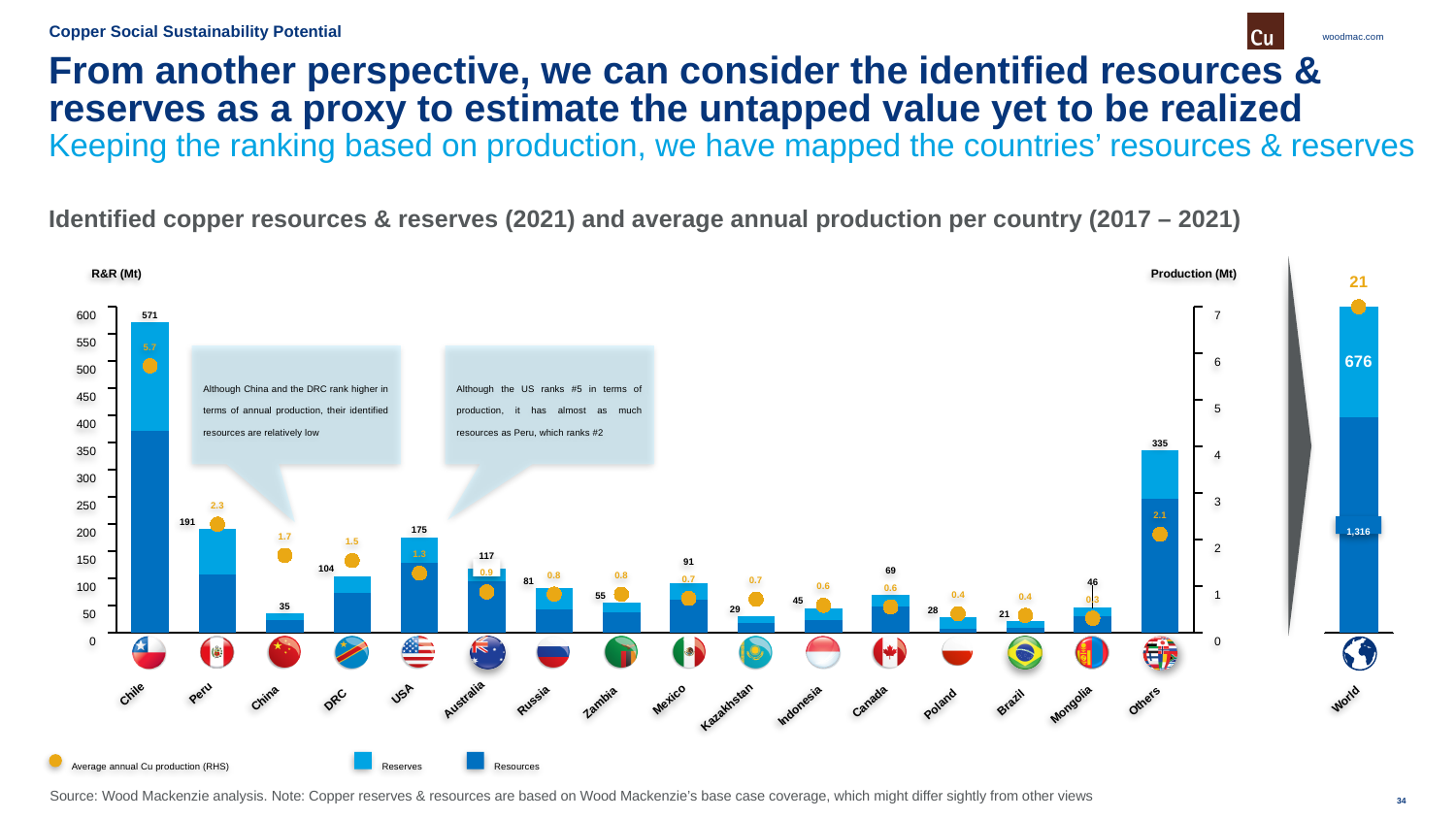
What is the difference in resources & reserves (Mt) between the USA and Australia? 58 What is the identified copper resources & reserves value (Mt) shown for Chile? 571 Which individual country has the highest identified resources & reserves total? Chile What is the average annual Cu production (Mt) shown for the World bar? 21 What is the title of the chart? Identified copper resources & reserves (2021) and average annual production per country (2017 – 2021) What is the difference in resources & reserves (Mt) between Chile and Peru? 380 Which has a larger resources & reserves total, the USA or the DRC? USA What kind of chart is used to show the resources & reserves per country? Stacked bar chart Which country has the lowest identified resources & reserves total? Brazil What is the identified copper resources & reserves value (Mt) shown for Others? 335 How many series does the legend list? 3 What is the average annual Cu production (Mt) shown for Peru? 2.3